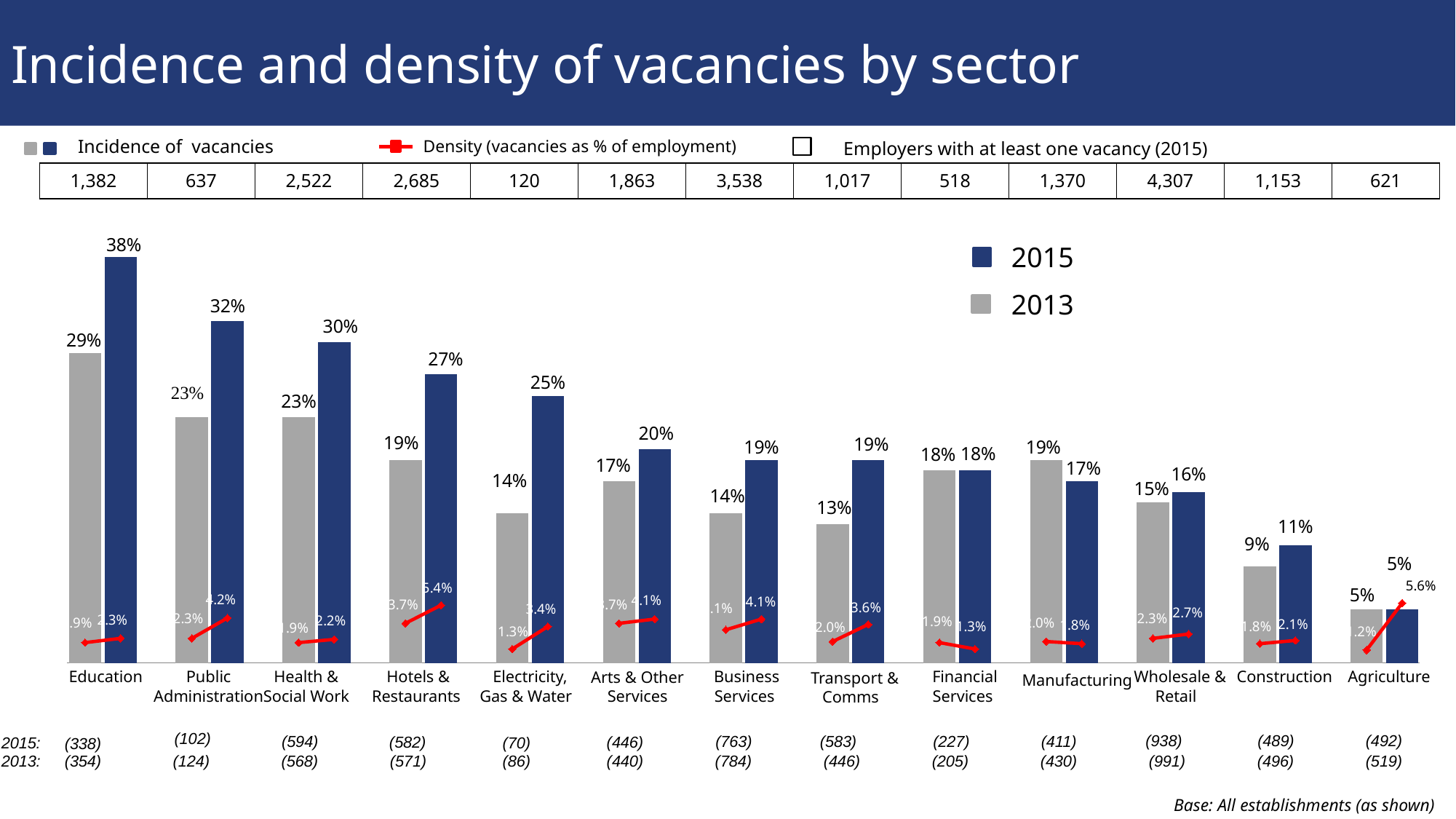
What kind of chart is used to show the incidence of vacancies? Bar chart Which sector has the highest 2015 incidence of vacancies? Education How many sectors are shown on the x axis of the chart? 13 What is the 2015 incidence of vacancies for Education? 38% Which sector has the lowest 2015 incidence of vacancies? Agriculture Which is larger for Manufacturing: the 2015 or the 2013 incidence of vacancies? 2013 Which colour represents 2015 in the bar chart? Dark blue How many years does the bar chart legend list? 2 What is the difference between the 2015 and 2013 incidence of vacancies for Electricity, Gas & Water? 11% What is the 2015 incidence of vacancies for Construction? 11% What is the 2013 incidence of vacancies for Manufacturing? 19% Do the 2015 incidence of vacancies values generally rise or fall from Education to Agriculture along the x axis? Fall